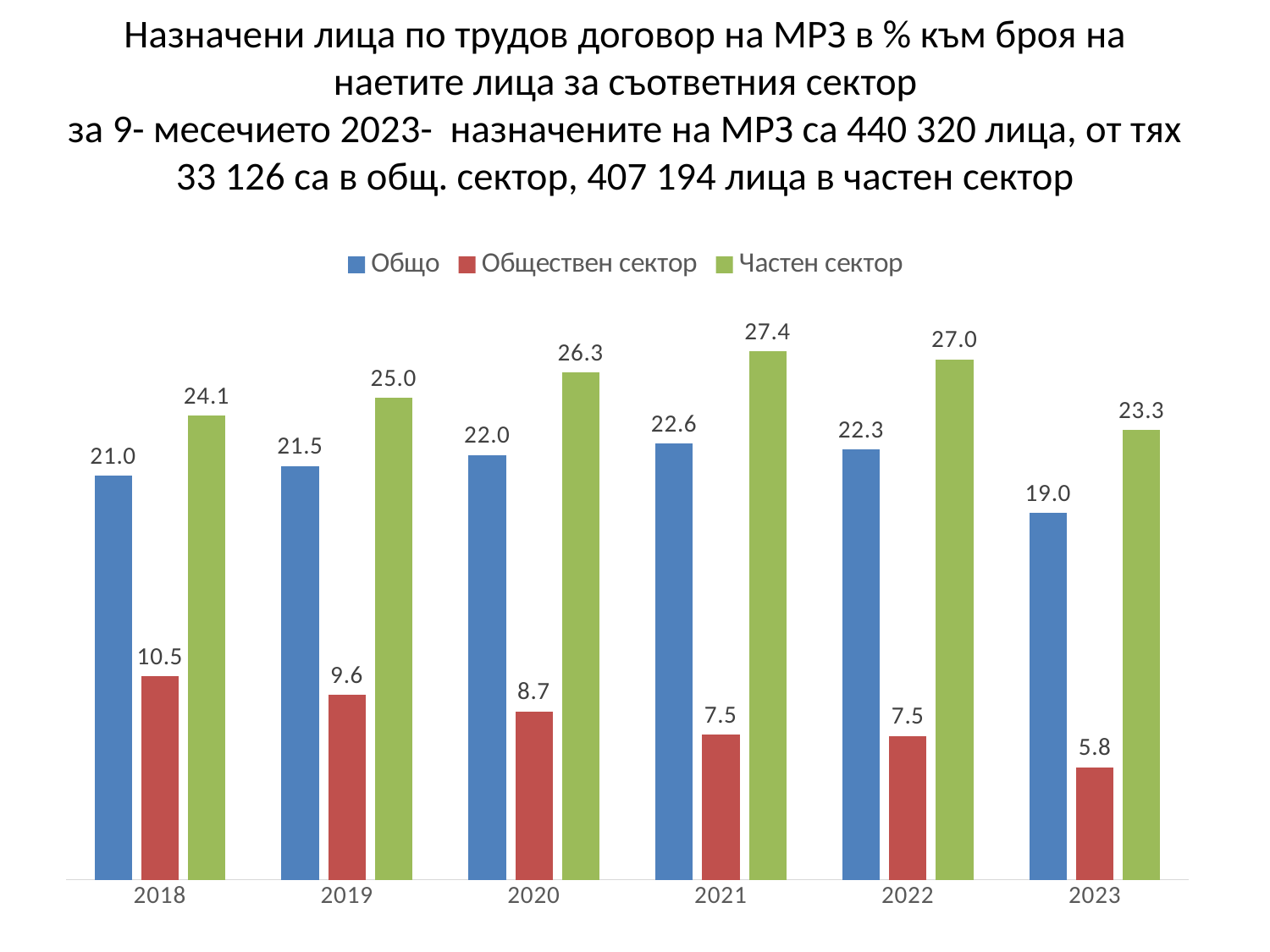
How many series does the legend list? 3 What is the value for Общо in 2018? 21.0 In which year is the Частен сектор value highest? 2021 Does the Обществен сектор value rise or fall from 2018 to 2023? fall What is the value for Обществен сектор in 2023? 5.8 What is the value for Частен сектор in 2021? 27.4 What kind of chart is shown on the slide? bar chart Which is larger, the Общо value in 2019 or the Общо value in 2022? 2022 What is the difference between the Частен сектор and Обществен сектор values in 2020? 17.6 In which year is the Обществен сектор value lowest? 2023 Which colour represents Частен сектор in the legend? green How many years are shown on the x axis? 6